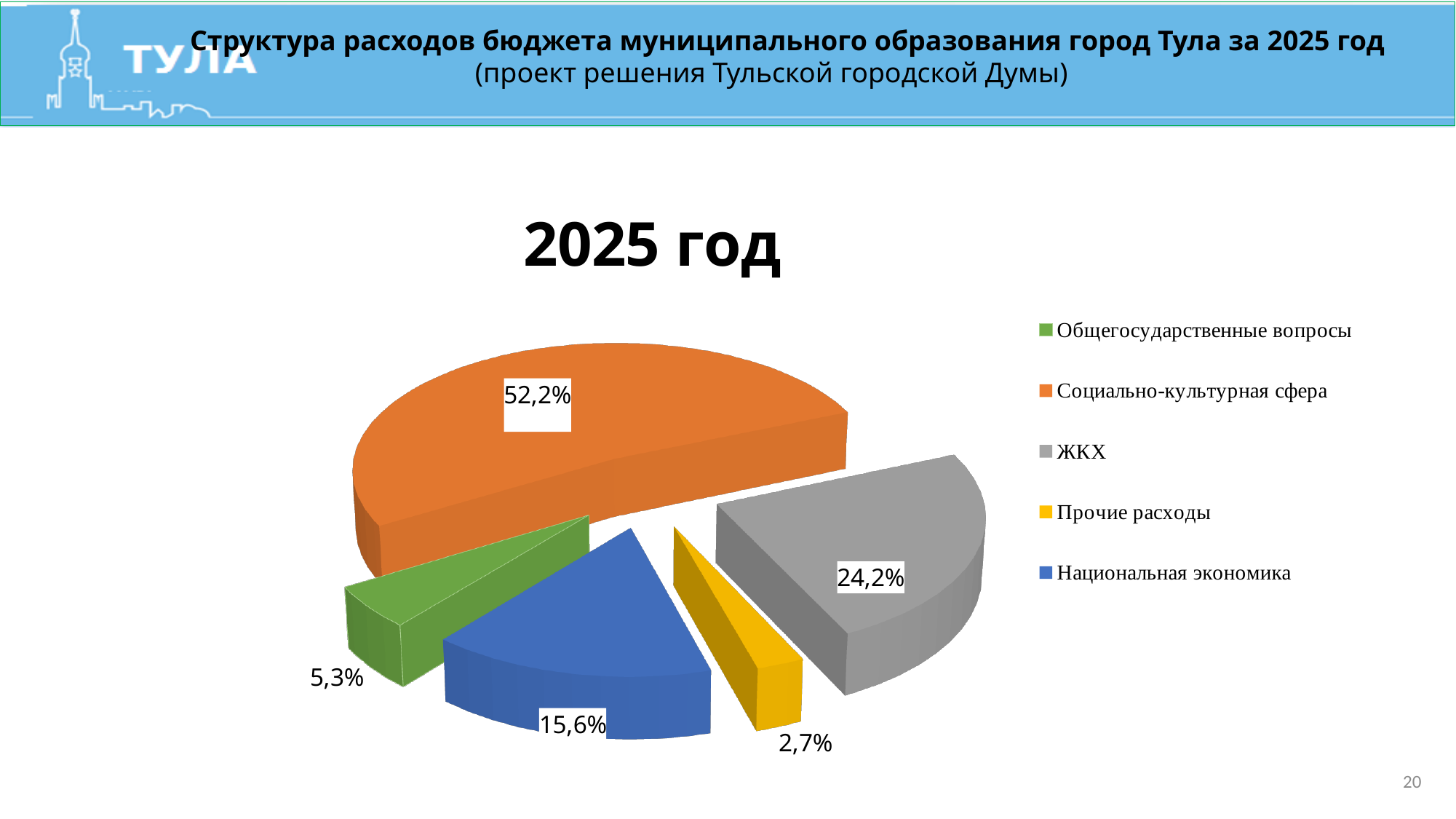
How many categories does the pie chart show? 5 What kind of chart is shown on the slide? Pie chart Which is larger, the share for Национальная экономика or the share for Общегосударственные вопросы? Национальная экономика What share of the pie does ЖКХ have? 24,2% Which category has the smallest share of the pie? Прочие расходы What share of the pie does Прочие расходы have? 2,7% What share of the pie does Общегосударственные вопросы have? 5,3% What colour is the slice for ЖКХ? Grey What is the difference in percentage points between Социально-культурная сфера and ЖКХ? 28,0 percentage points Which category has the largest share of the pie? Социально-культурная сфера